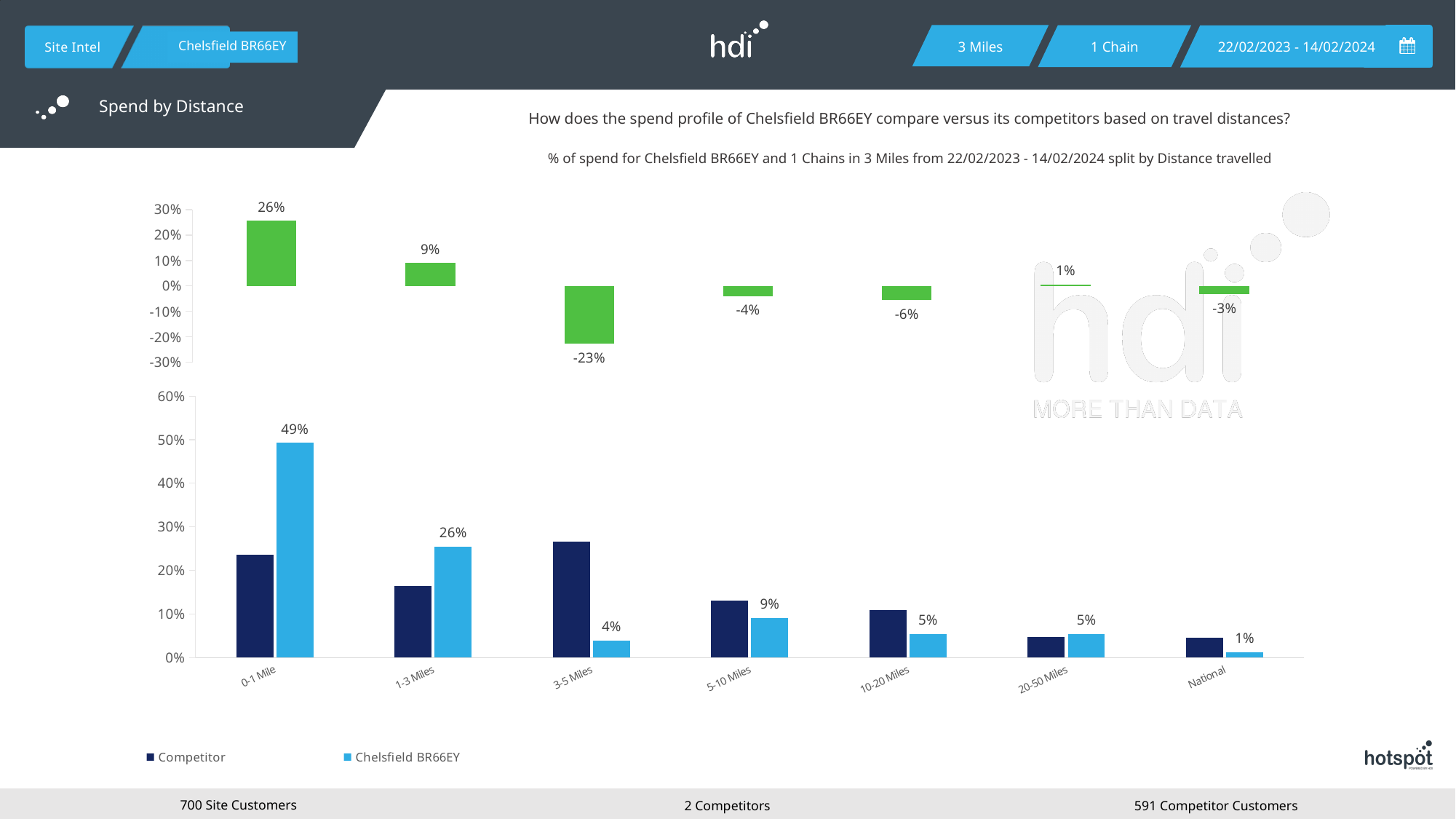
How many distance categories are shown on the x axis of the bottom chart? 7 In the bottom chart, what is the value for Chelsfield BR66EY in the 0-1 Mile category? 49% In the bottom chart, which category has the highest Chelsfield BR66EY value? 0-1 Mile In the bottom chart, for the 3-5 Miles category, which series has the larger value: Competitor or Chelsfield BR66EY? Competitor How many series does the legend of the bottom chart list? 2 In the bottom chart, what is the difference between the Chelsfield BR66EY values for 0-1 Mile and 1-3 Miles? 23% What kind of chart is the bottom chart? bar chart In the bottom chart, is the Competitor value for 0-1 Mile greater or less than 20%? greater In the top green chart, what is the lowest value shown? -23% In the bottom chart, which category has the lowest Chelsfield BR66EY value? National In the bottom chart, is the Competitor value for 3-5 Miles greater or less than 30%? less In the bottom chart, what is the value for Chelsfield BR66EY in the 5-10 Miles category? 9%